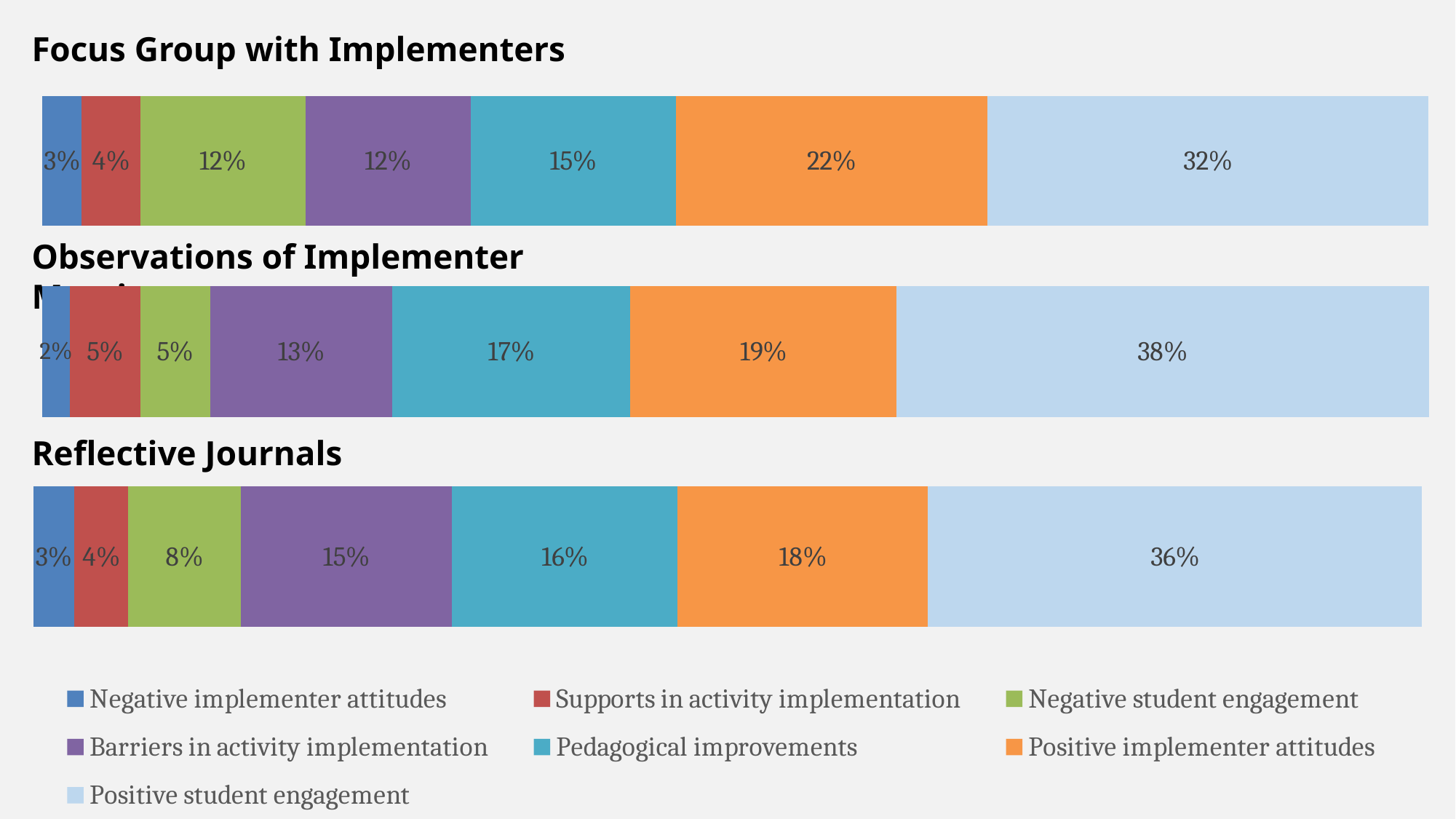
In the Focus Group with Implementers chart, what percentage is shown for Negative student engagement? 12% Is the Positive implementer attitudes value larger in the Focus Group with Implementers chart or in the Reflective Journals chart? Focus Group with Implementers What kind of chart is the Reflective Journals chart? Stacked bar chart In the Reflective Journals chart, what percentage is shown for Barriers in activity implementation? 15% In the Focus Group with Implementers chart, what percentage is shown for Positive student engagement? 32% In the Reflective Journals chart, how many percentage points larger is Positive student engagement than Positive implementer attitudes? 18 percentage points What colour represents Positive student engagement in the legend? Light blue In the middle chart (Observations of Implementer...), which category has the smallest segment? Negative implementer attitudes What is the total of all segments in the Focus Group with Implementers bar? 100% In the middle chart (Observations of Implementer...), what percentage is shown for Pedagogical improvements? 17% How many series does the legend list? 7 In the Focus Group with Implementers chart, which category has the largest segment? Positive student engagement